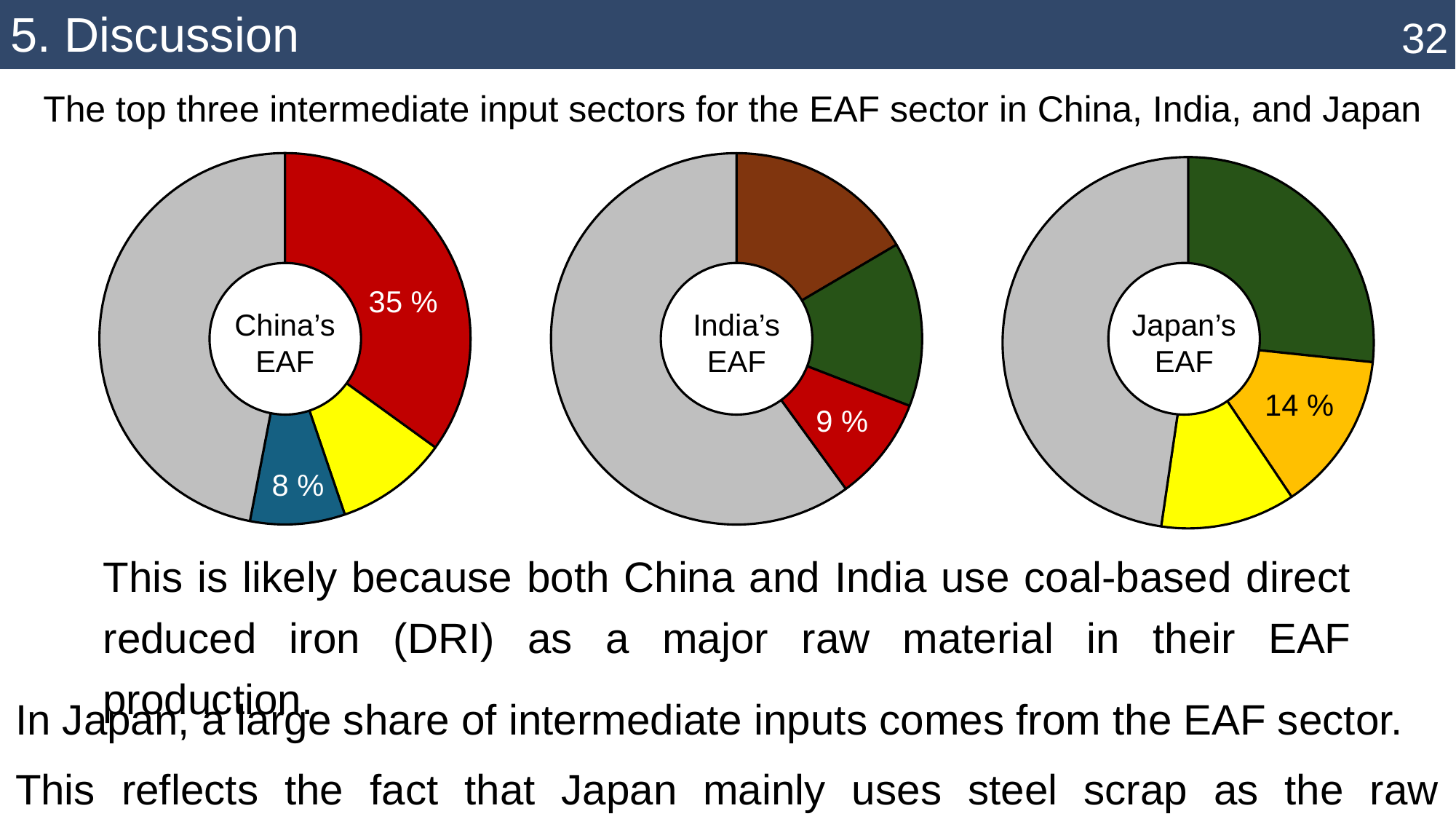
How many slices does the India's EAF chart have? 4 How many pie charts are shown on the slide? 3 What kind of chart is used to show the intermediate input sectors for each country's EAF sector? pie (donut) chart What is the title written above the three charts? The top three intermediate input sectors for the EAF sector in China, India, and Japan In the China's EAF chart, which is larger: the red slice or the grey slice? the grey slice In the India's EAF chart, what share is labelled on the red slice? 9 % In the China's EAF chart, what is the difference between the red slice and the blue slice? 27 % Which is larger: the orange slice in the Japan's EAF chart or the red slice in the India's EAF chart? the orange slice in Japan's EAF chart In the China's EAF chart, what share is labelled on the red slice? 35 % In the Japan's EAF chart, what share is labelled on the orange slice? 14 % What text is written in the centre of the middle chart? India's EAF In the China's EAF chart, what share is labelled on the blue slice? 8 %